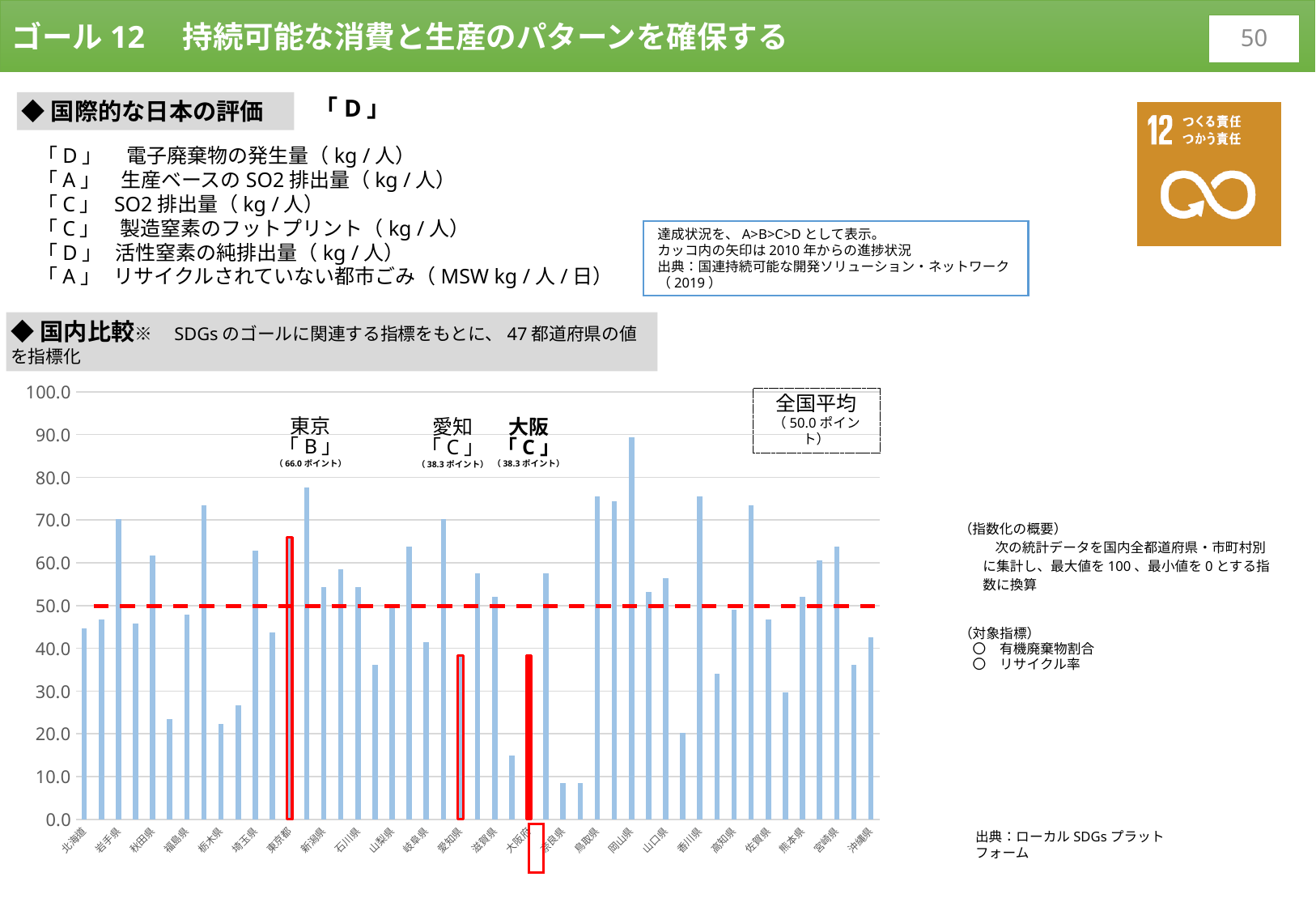
Is the value for 奈良県 greater or less than 10.0? less What is the 全国平均 value shown on the chart? 50.0 ポイント What kind of chart is shown in the 国内比較 section? bar chart What is the value for 東京 shown on the chart? 66.0 ポイント Which prefecture has the highest bar on the chart? 岡山県 Is the value for 北海道 greater or less than 50.0? less What is the difference between the value for 東京 and the 全国平均? 16.0 ポイント What grade is shown for 東京 on the chart? 「B」 Which is larger, the value for 東京 or the value for 大阪? 東京 Is the value for 新潟県 greater or less than 70.0? less What is the value for 愛知 shown on the chart? 38.3 ポイント What is the difference between the value for 東京 and the value for 愛知? 27.7 ポイント